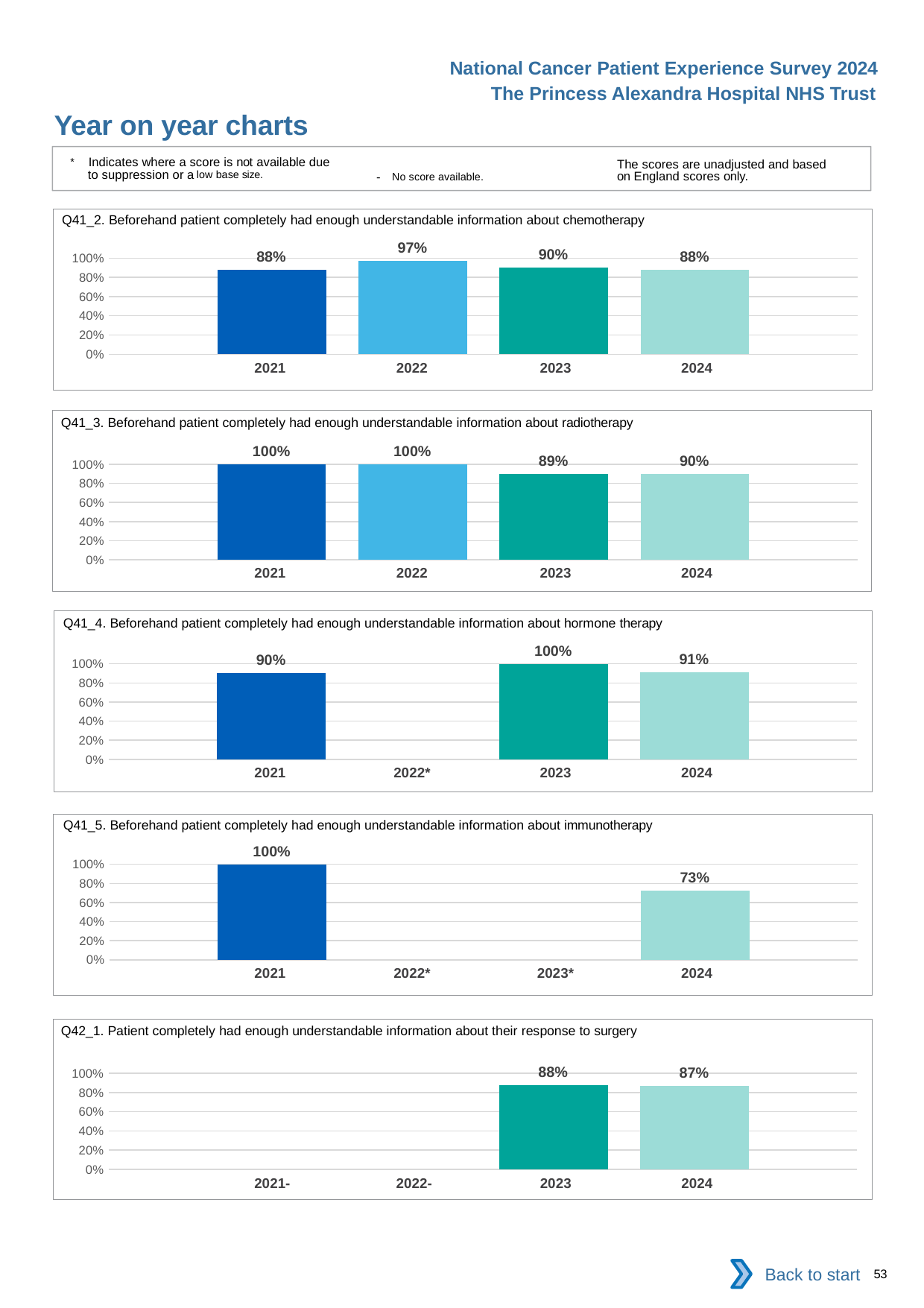
In the Q41_3 chart (radiotherapy), what is the value for 2023? 89% In the Q41_4 chart (hormone therapy), what is the value for 2024? 91% In the Q41_4 chart (hormone therapy), which year has the lowest plotted value? 2021 In the Q42_1 chart (response to surgery), how many years have a bar plotted? 2 In the Q41_3 chart (radiotherapy), what is the difference between the 2021 and 2024 values? 10% What type of chart is the Q41_2 chart (chemotherapy)? Bar chart In the Q41_2 chart (chemotherapy), what is the value for 2022? 97% How many charts are shown on the slide? 5 In the Q42_1 chart (response to surgery), which is larger, the 2023 value or the 2024 value? 2023 In the Q41_5 chart (immunotherapy), what is the value for 2024? 73% In the Q41_5 chart (immunotherapy), what is the difference between the 2021 and 2024 values? 27% In the Q41_2 chart (chemotherapy), which year has the highest value? 2022